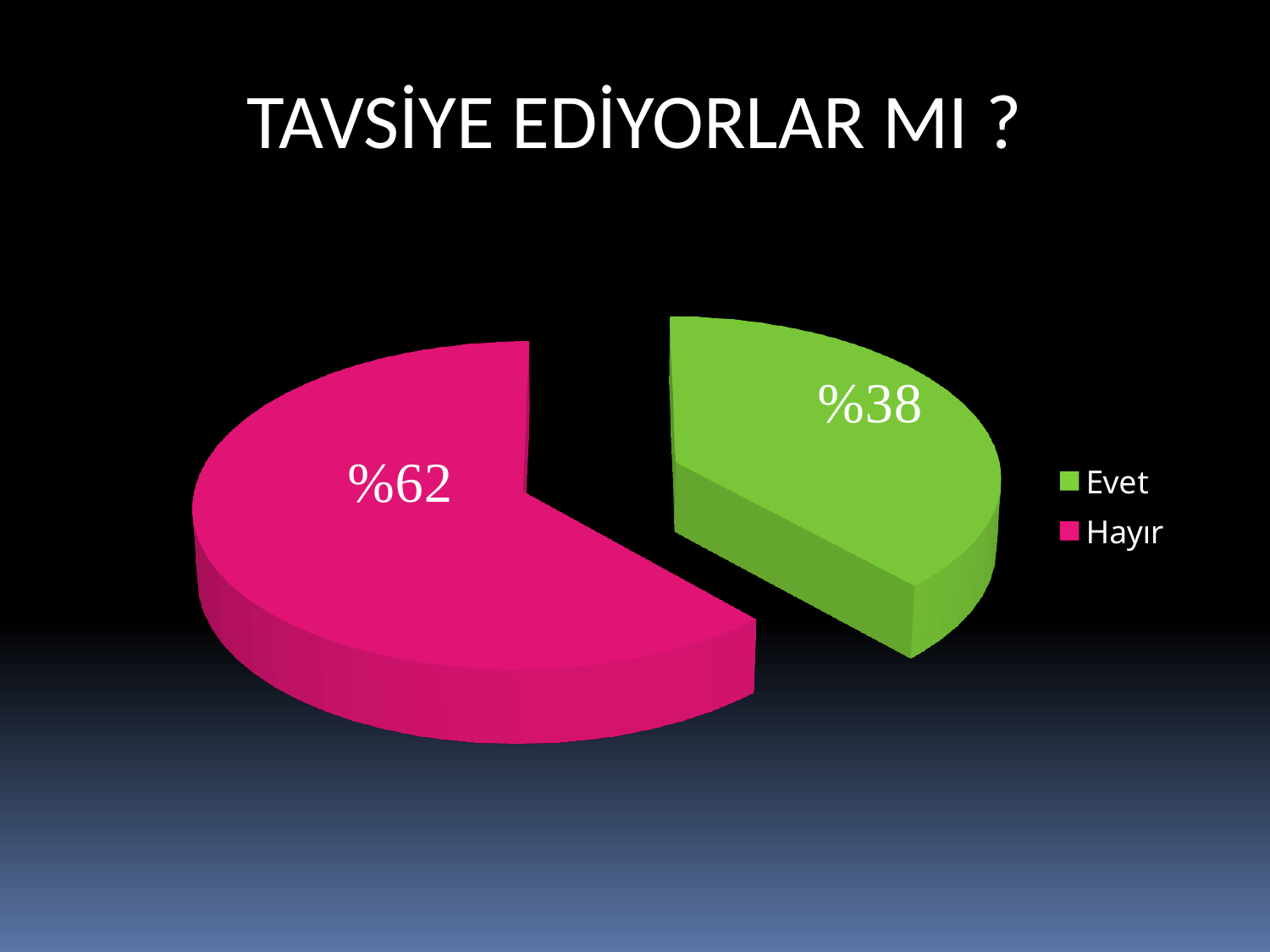
How many slices does the pie chart have? 2 Which is larger, the Evet slice or the Hayır slice? Hayır What colour is the Evet slice? Green What share of the pie does Evet represent? %38 What kind of chart is shown on the slide? Pie chart What share of the pie does Hayır represent? %62 What is the title of the slide? TAVSİYE EDİYORLAR MI ? What is the difference in percentage points between the Hayır and Evet slices? 24 Which category has the smallest slice of the pie? Evet How many entries does the legend list? 2 Which category has the largest slice of the pie? Hayır